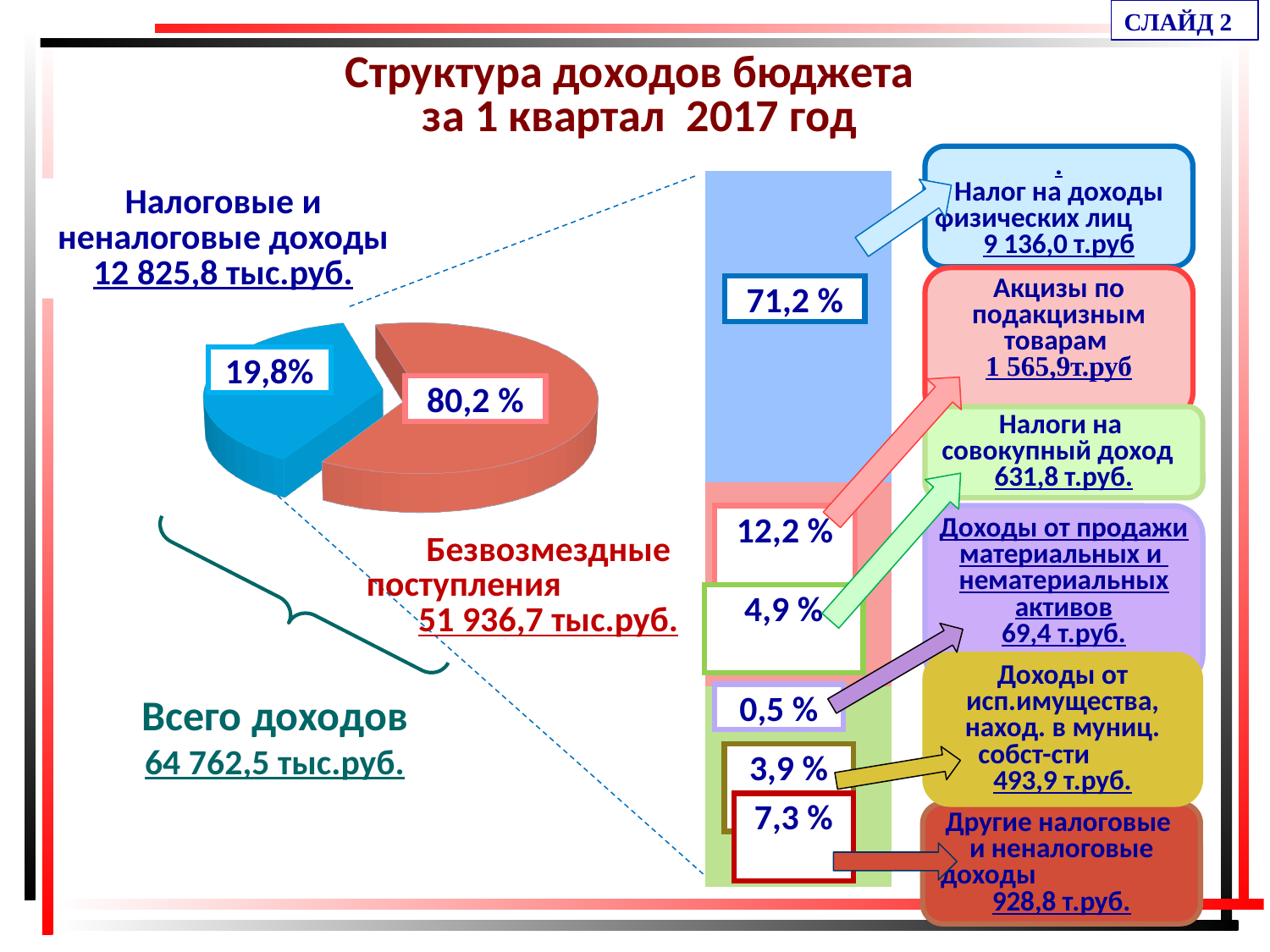
What type of chart is shown on the left of the slide? pie chart In the pie chart, what share is shown for «Налоговые и неналоговые доходы»? 19,8% In the stacked bar on the right, what percentage corresponds to «Налог на доходы физических лиц»? 71,2 % What is the difference between the percentages for «Налог на доходы физических лиц» (71,2 %) and «Акцизы по подакцизным товарам» (12,2 %) in the stacked bar? 59,0 % How many slices does the pie chart have? 2 In the pie chart, which slice is larger: «Налоговые и неналоговые доходы» or «Безвозмездные поступления»? Безвозмездные поступления In the stacked bar on the right, what percentage corresponds to «Акцизы по подакцизным товарам»? 12,2 % In the stacked bar on the right, which segment has the smallest percentage? Доходы от продажи материальных и нематериальных активов (0,5 %) In the pie chart, what share is shown for «Безвозмездные поступления»? 80,2 % What amount is shown for «Налоги на совокупный доход» in the stacked bar breakdown? 631,8 т.руб. In the stacked bar on the right, which segment has the largest percentage? Налог на доходы физических лиц (71,2 %) What is the amount shown for «Всего доходов»? 64 762,5 тыс.руб.